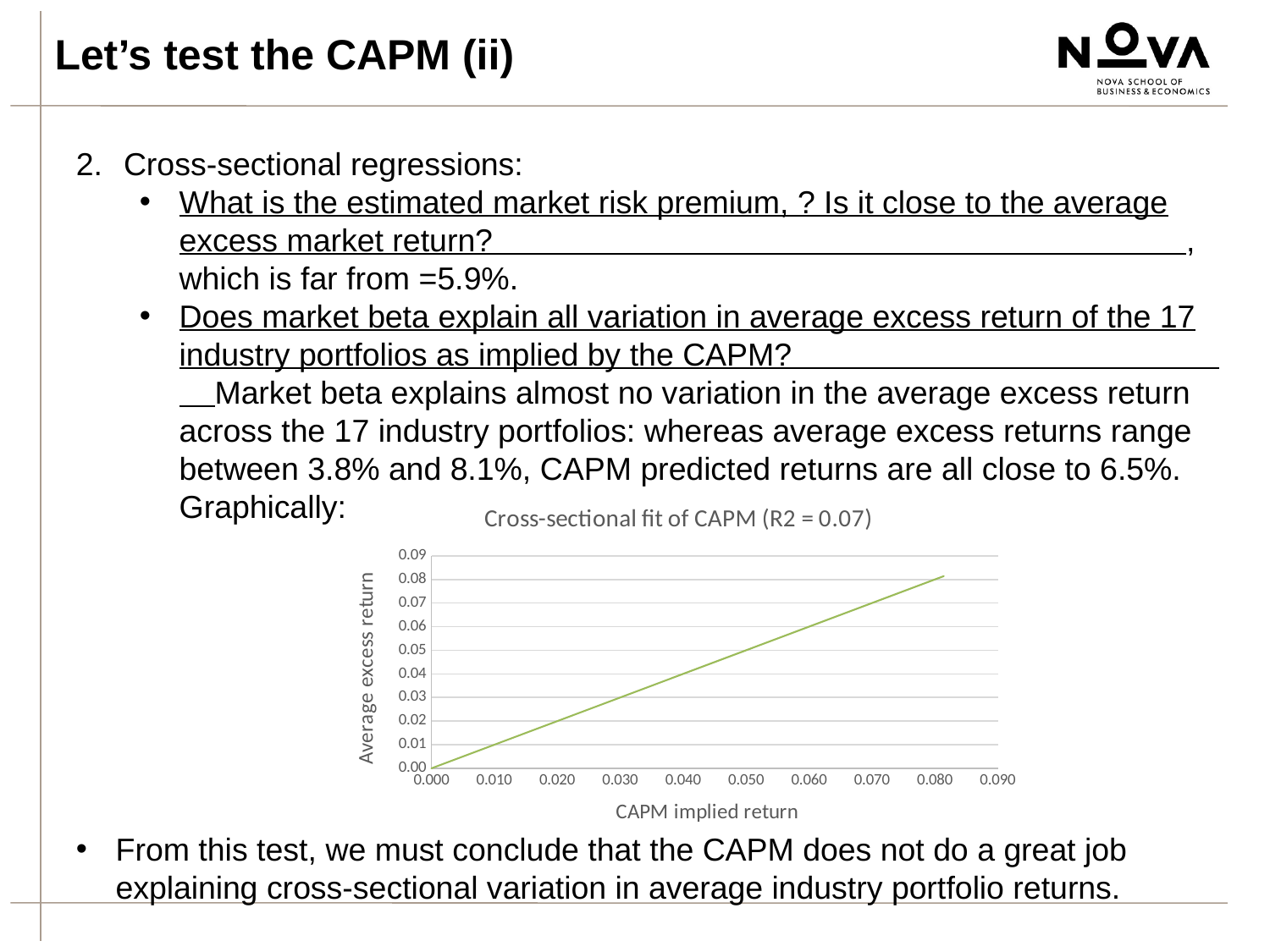
What kind of chart is shown on the slide? line chart What is the title of the chart? Cross-sectional fit of CAPM (R2 = 0.07) What is the highest value shown on the y axis of the chart? 0.09 What is the highest value shown on the x axis of the chart? 0.090 Is the average excess return on the line at a CAPM implied return of 0.020 greater or less than 0.03? less What R2 value is reported in the chart title? 0.07 Does the plotted line rise or fall as the CAPM implied return increases? rise What is the label of the x axis of the chart? CAPM implied return How many lines are plotted on the chart? 1 Is the average excess return on the line at a CAPM implied return of 0.080 greater or less than 0.07? greater